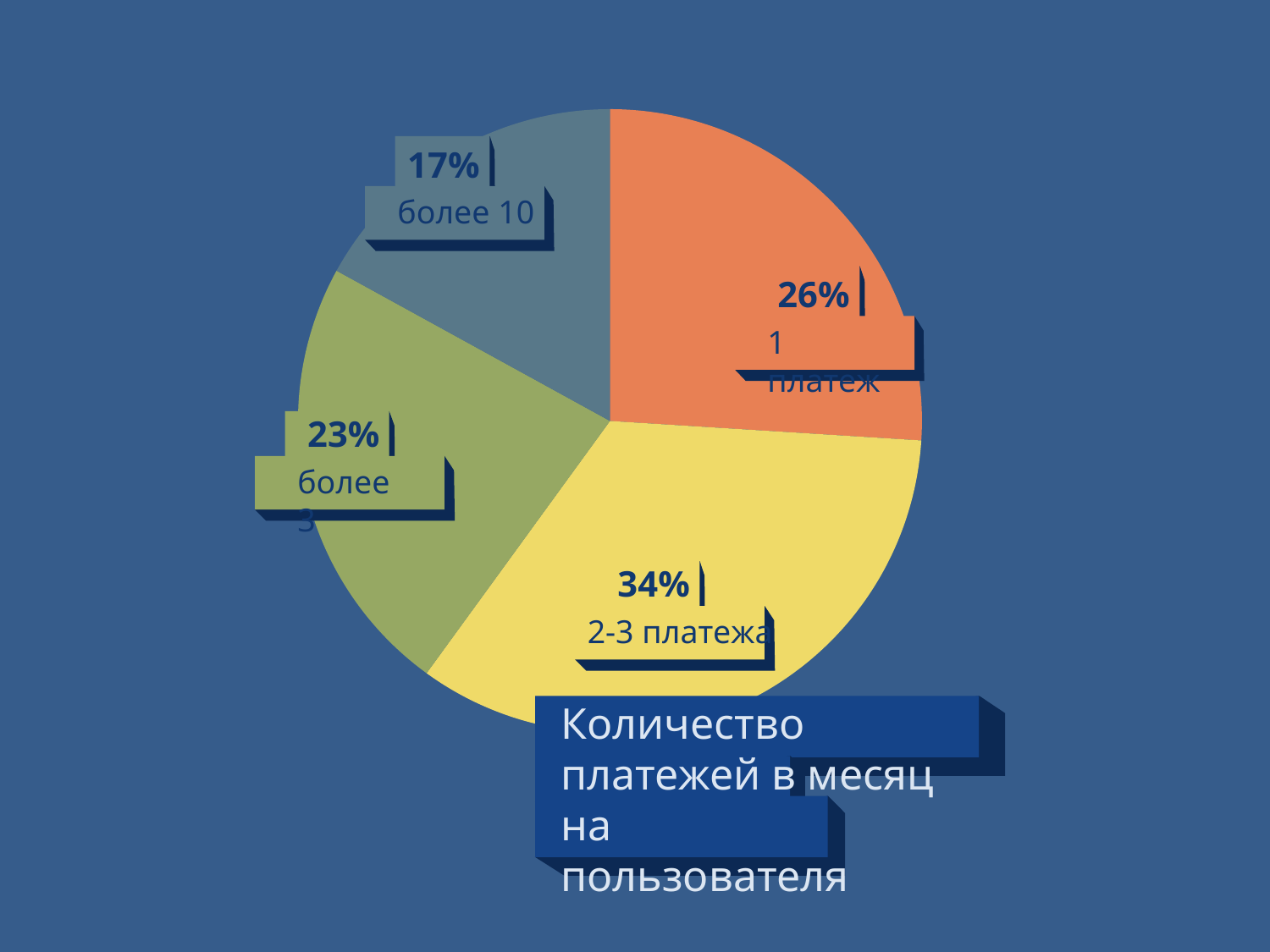
Which category has the smallest share of the pie? более 10 Which category has the largest share of the pie? 2-3 платежа What colour is the "2-3 платежа" slice? yellow Which slice is larger: "1 платеж" or "более 3"? 1 платеж What is the difference in percentage points between the "2-3 платежа" slice and the "более 10" slice? 17 What type of chart is shown on the slide? pie chart What share of the pie does the "более 3" slice represent? 23% What share of the pie does the "2-3 платежа" slice represent? 34% What share of the pie does the "1 платеж" slice represent? 26% How many slices does the pie chart have? 4 What is the title of the chart? Количество платежей в месяц на пользователя What share of the pie does the "более 10" slice represent? 17%